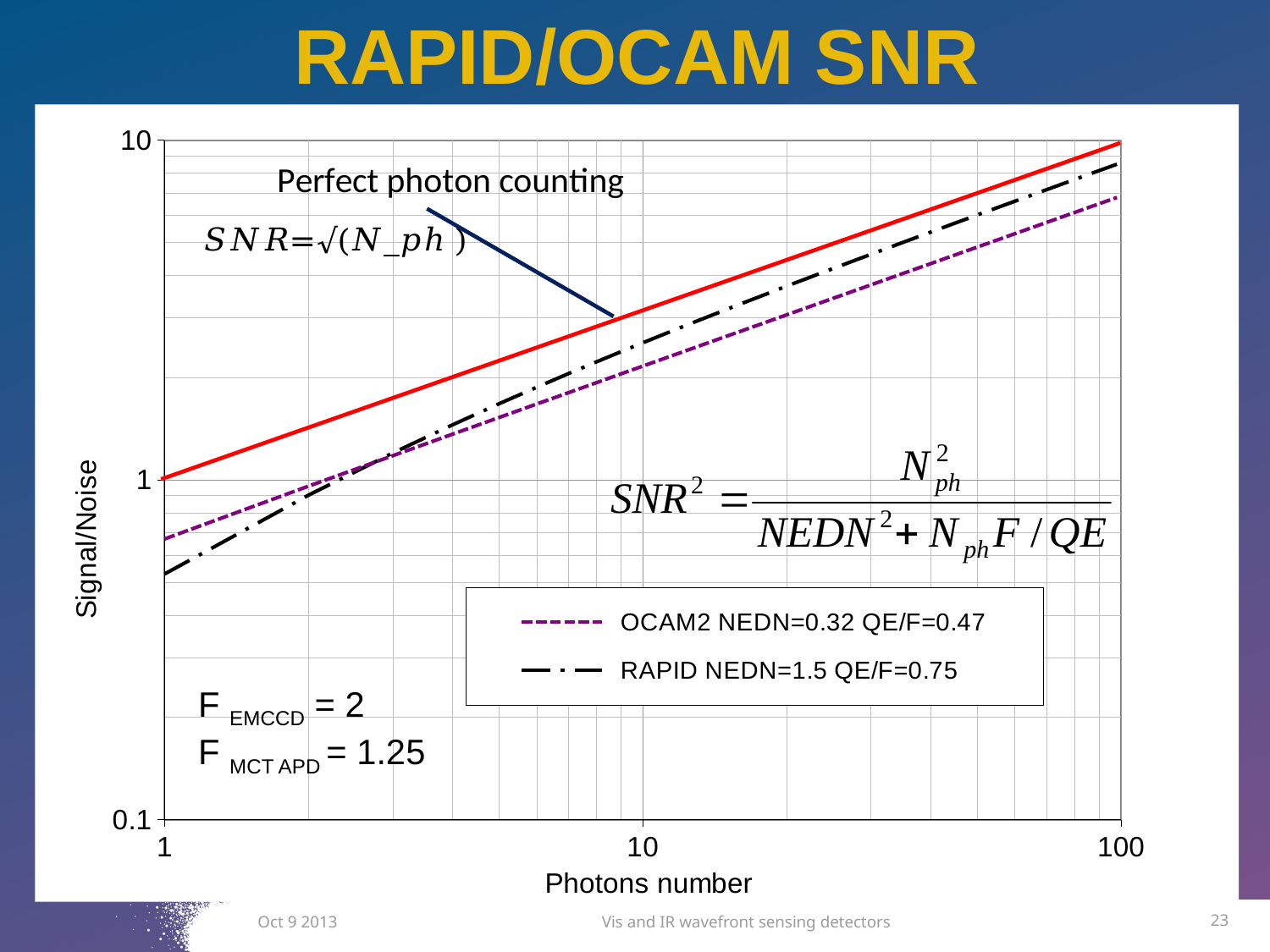
At 1 photon, is the Signal/Noise value for OCAM2 greater or less than 1? less At 100 photons, is the Signal/Noise value for RAPID greater or less than 1? greater How many series does the chart's legend list? 2 Which line has the highest Signal/Noise at 100 photons? Perfect photon counting What is the label of the x axis? Photons number At 100 photons, which has the higher Signal/Noise, RAPID or OCAM2? RAPID What kind of chart is shown on the slide? line chart Do the Signal/Noise values rise or fall as the photons number increases? rise At 1 photon, which has the higher Signal/Noise, RAPID or OCAM2? OCAM2 What is the Signal/Noise value of the perfect photon counting line at 1 photon? 1 At 1 photon, is the Signal/Noise value for RAPID greater or less than 0.1? greater What is the label of the y axis? Signal/Noise